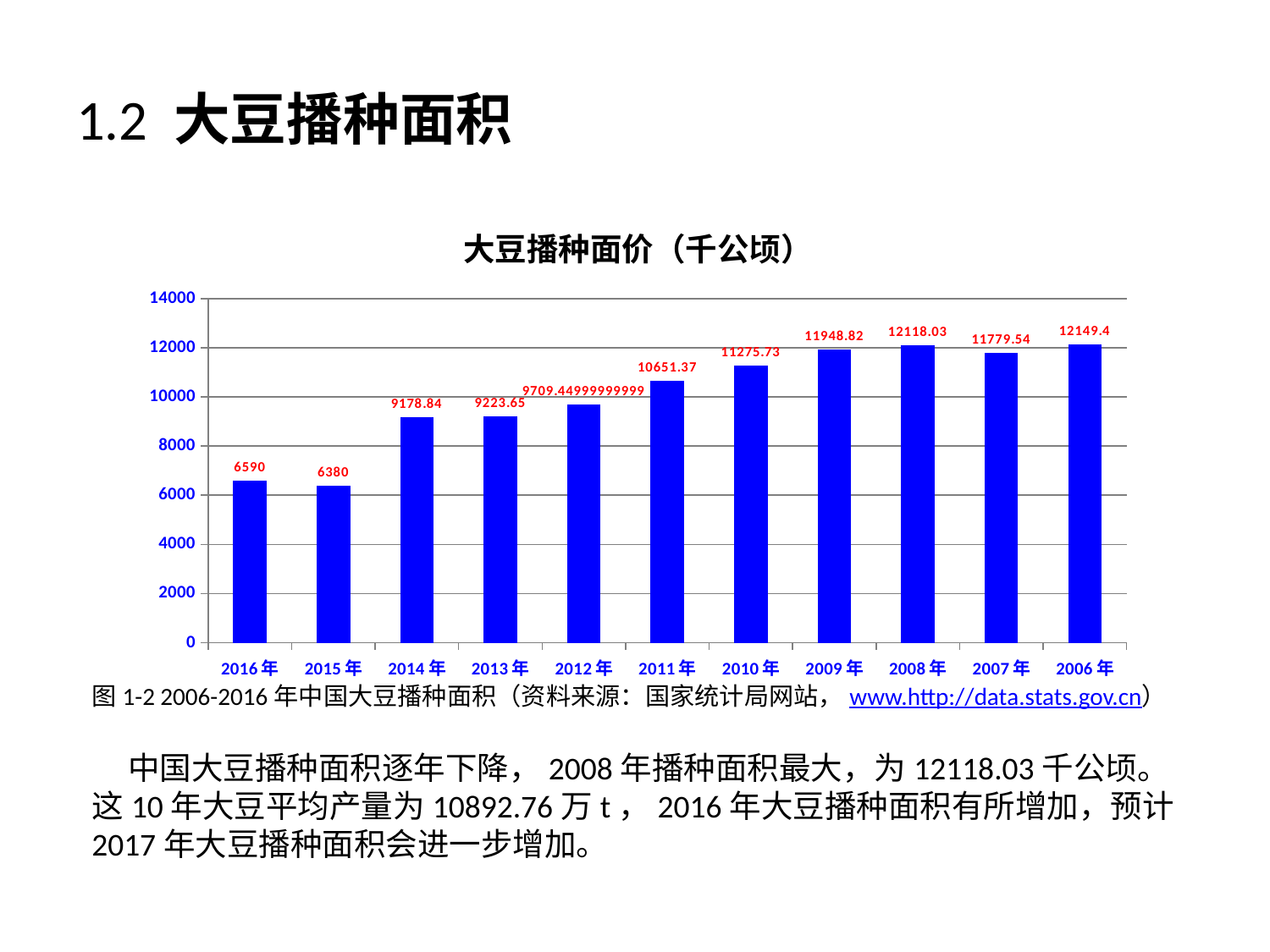
What is the value for 2008年? 12118.03 What type of chart is shown on the slide? bar chart Which year has the highest value? 2006年 Which is larger, the value for 2009年 or the value for 2007年? 2009年 What is the difference between the values for 2016年 and 2015年? 210 What is the title of the chart? 大豆播种面价（千公顷） What is the value for 2011年? 10651.37 Is the value for 2012年 greater or less than 10000? less What is the value for 2016年? 6590 How many years (bars) are shown in the chart? 11 What is the value for 2014年? 9178.84 Which year has the lowest value? 2015年